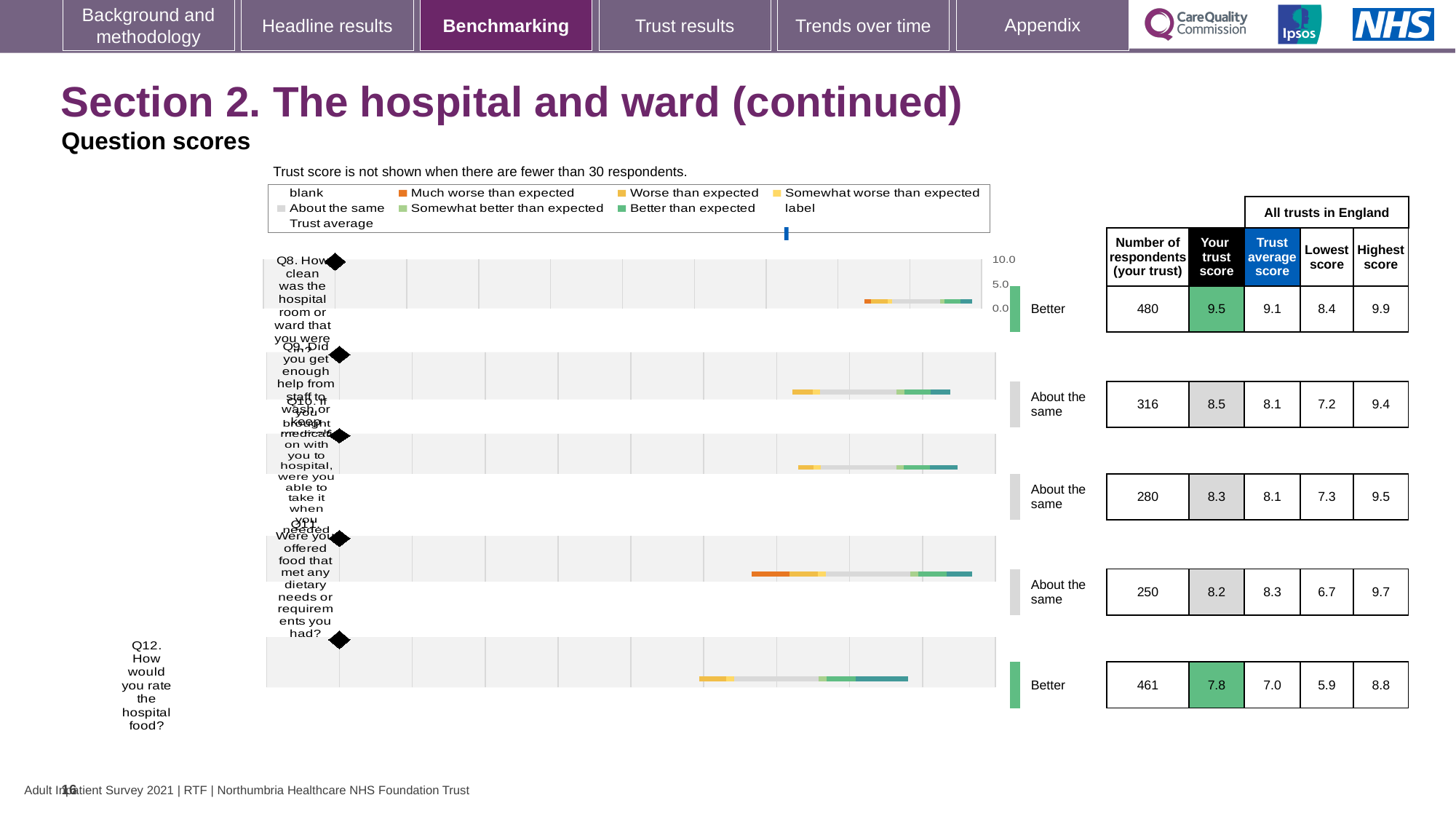
Which question has the lowest trust score? Q12 What benchmark category is shown for Q12? Better Which question has the highest trust score? Q8 How many questions are plotted on the chart? 5 What is the trust score for Q12 (how would you rate the hospital food)? 7.8 What kind of chart is used to show the question scores? Bar chart How many respondents answered Q11 (food that met dietary needs) at this trust? 250 What is the trust average score across all trusts in England for Q12? 7.0 What is the difference between the highest score and the lowest score for Q12? 2.9 What is the trust score for Q8 (how clean was the hospital room or ward)? 9.5 Which is larger for Q11: the trust score or the trust average score? Trust average score What is the difference between the trust score and the trust average score for Q8? 0.4